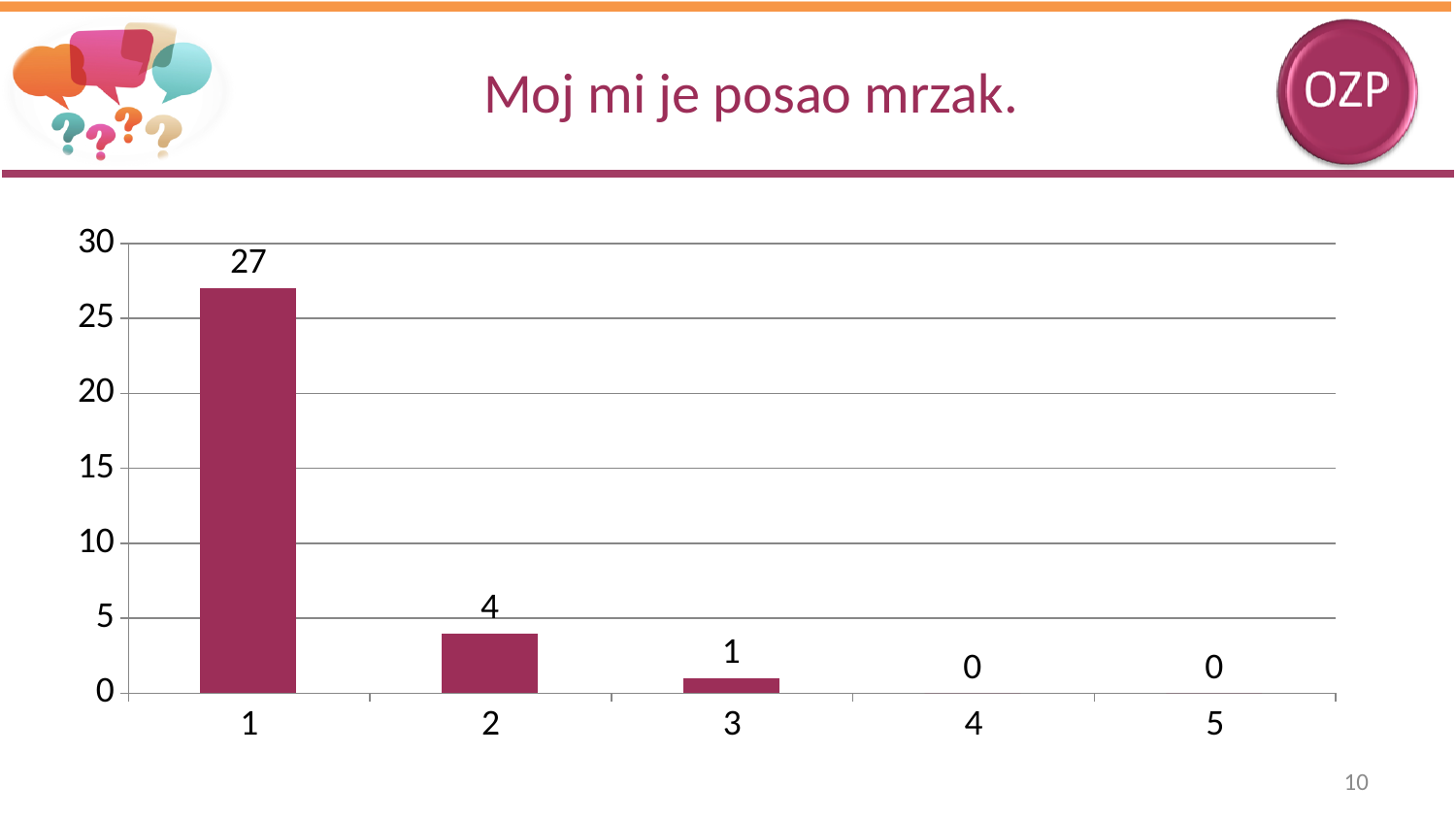
What is the value for category 1? 27 What is the title of the slide? Moj mi je posao mrzak. How many categories are shown on the x axis? 5 What is the value for category 3? 1 What is the value for category 4? 0 What kind of chart is shown on the slide? bar chart Do the values rise or fall from category 1 to category 5? fall Which category has the highest value? 1 What is the value for category 2? 4 What is the difference between the values for category 1 and category 2? 23 Which is larger, the value for category 2 or category 3? 2 Is the value for category 1 greater or less than 25? greater